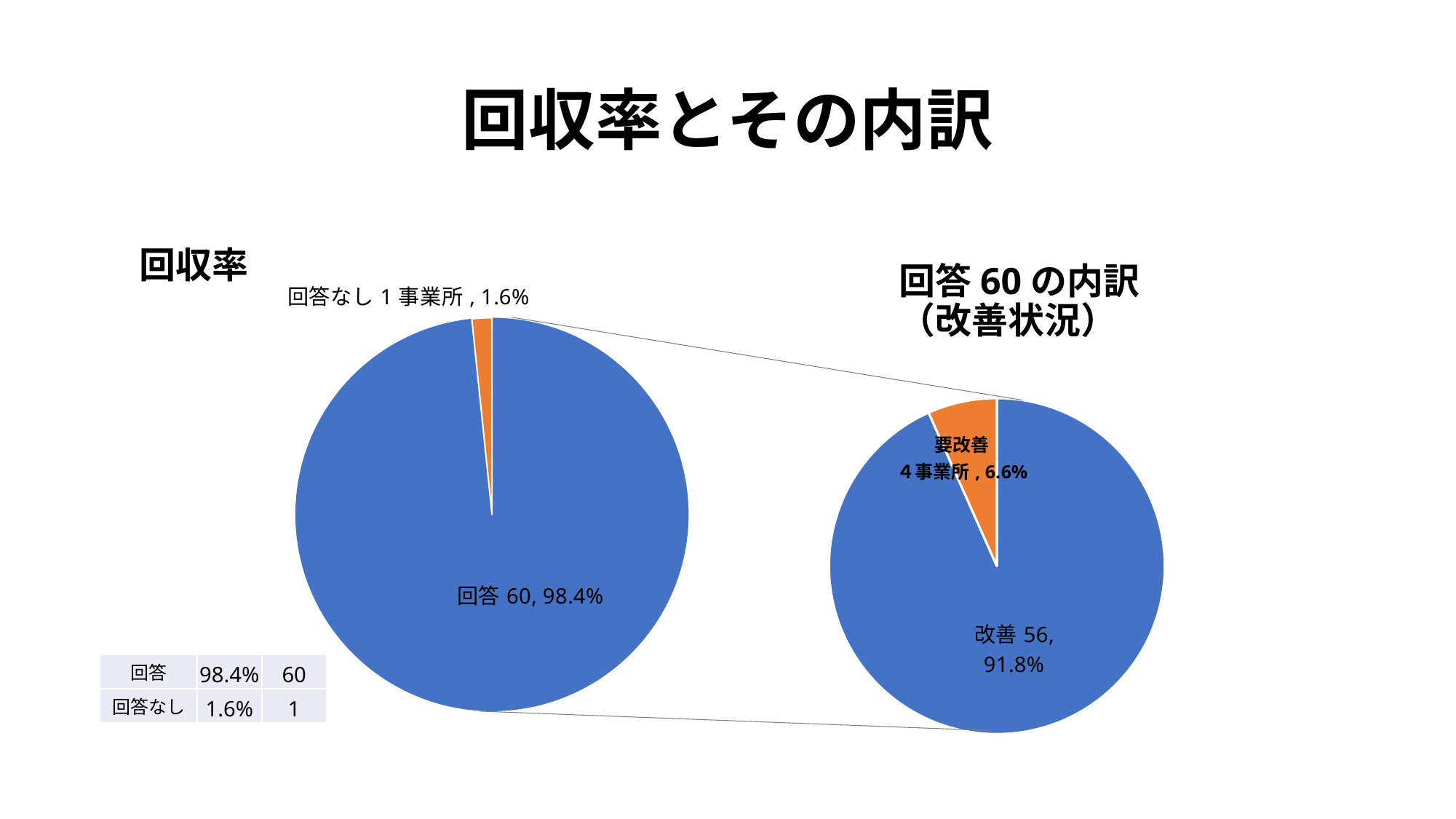
In the 回答 60 の内訳（改善状況） pie chart, what is the share shown for 改善? 91.8% What type of chart is used on the left side of the slide (回収率)? Pie chart In the 回答 60 の内訳（改善状況） pie chart, which slice is the smallest? 要改善 In the 回収率 pie chart, what is the share shown for 回答? 98.4% In the 回収率 pie chart, which slice is the largest? 回答 In the 回収率 pie chart, how many 事業所 are labelled as 回答なし? 1 In the 回答 60 の内訳（改善状況） pie chart, what is the difference in count between 改善 and 要改善? 52 In the 回収率 pie chart, what is the share shown for 回答なし? 1.6% In the 回収率 pie chart, what count is shown for 回答? 60 In the 回答 60 の内訳（改善状況） pie chart, how many 事業所 are labelled 要改善? 4 How many slices does the 回収率 pie chart have? 2